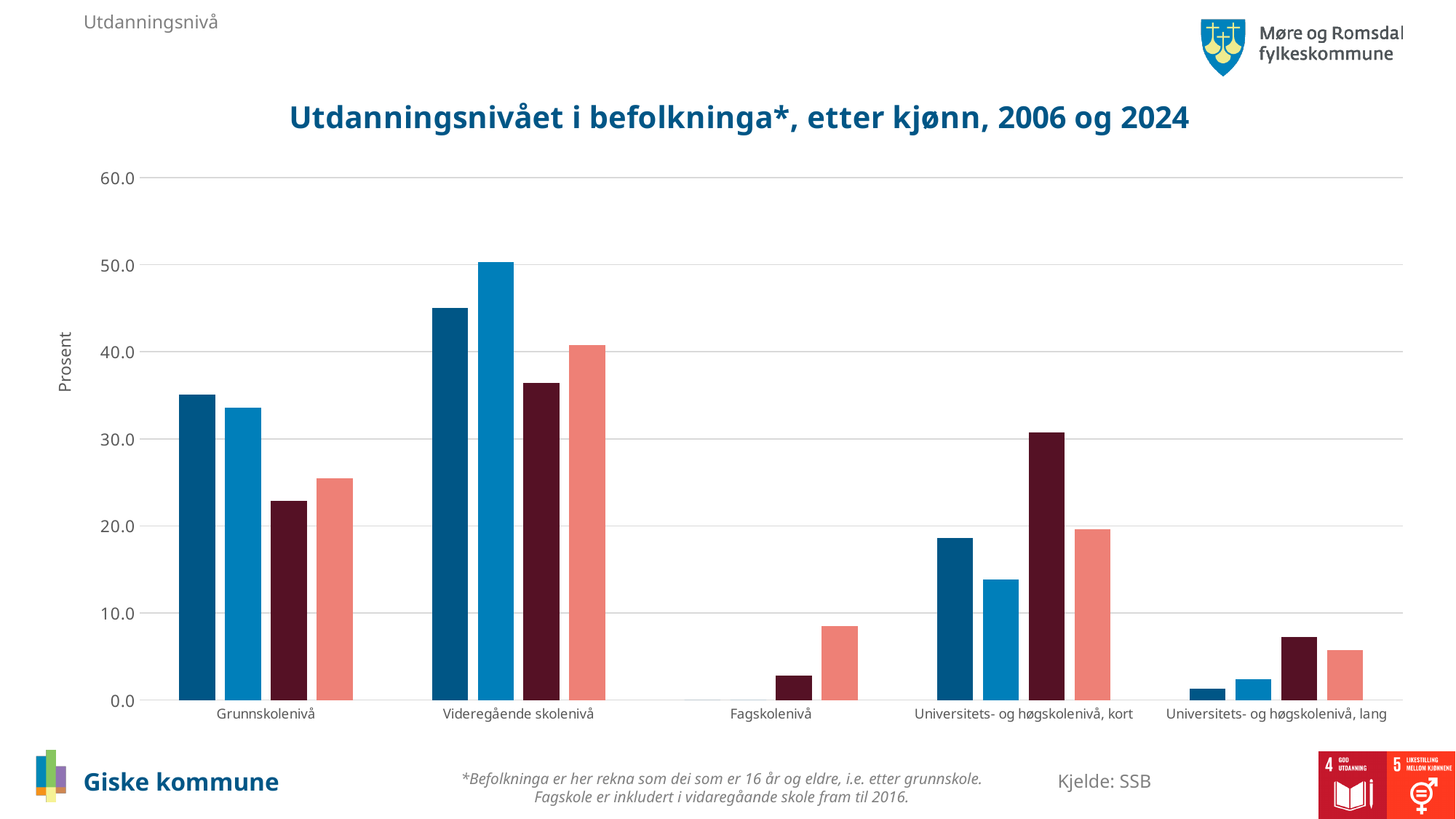
What kind of chart is shown on the slide? bar chart How many bars are visible for the Fagskolenivå category? 2 Which category has the larger tallest bar: Grunnskolenivå or Universitets- og høgskolenivå, lang? Grunnskolenivå Is the value of the tallest bar for Videregående skolenivå greater or less than 40? greater What is the title of the chart? Utdanningsnivået i befolkninga*, etter kjønn, 2006 og 2024 How many categories are shown on the x axis of the chart? 5 Is the value of the first (dark blue) bar for Grunnskolenivå greater or less than 30? greater Is the value of the tallest bar for Fagskolenivå greater or less than 10? less Which category contains the tallest bar in the chart? Videregående skolenivå What is the label on the y axis of the chart? Prosent